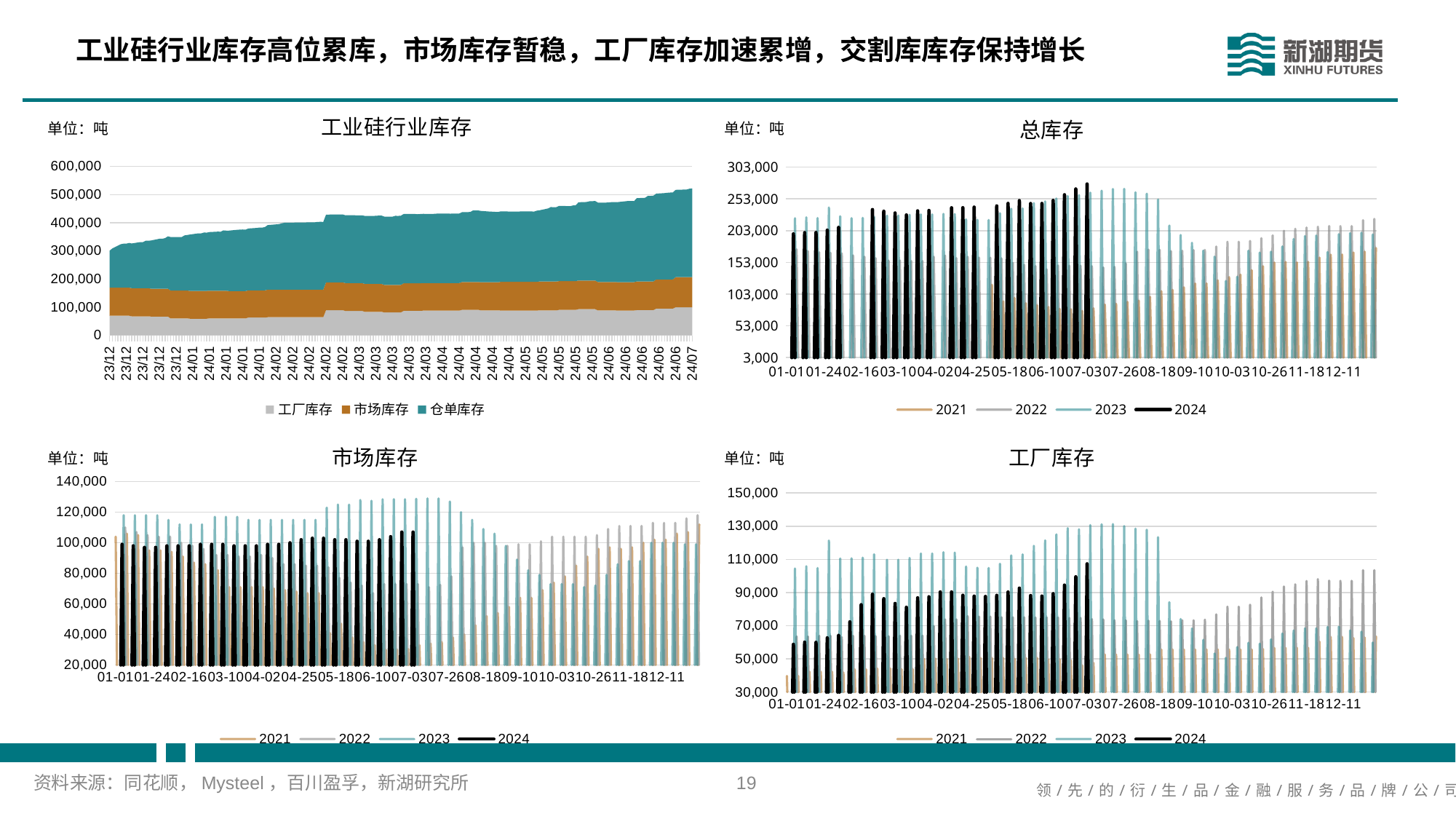
In the 总库存 chart, is the last 2024 value (early July) greater or less than 253,000? greater In the 工业硅行业库存 chart, does the total stacked inventory rise or fall from 23/12 to 24/07? Rise What kind of chart is the 工业硅行业库存 chart? Stacked area chart In the 工厂库存 chart, is the last 2024 value (early July) greater or less than 90,000? greater In the 工业硅行业库存 chart, is the total stacked value at 24/07 greater or less than 500,000? greater How many series does the legend of the 总库存 chart list? 4 In the 总库存 chart, does the 2024 series rise or fall from January to July? Rise In the 工厂库存 chart, does the 2024 series rise or fall from January to July? Rise What kind of chart is the 市场库存 chart? Line chart Which series in the 工业硅行业库存 chart is shown in teal at the top of the stack? 仓单库存 How many series does the legend of the 工业硅行业库存 chart list? 3